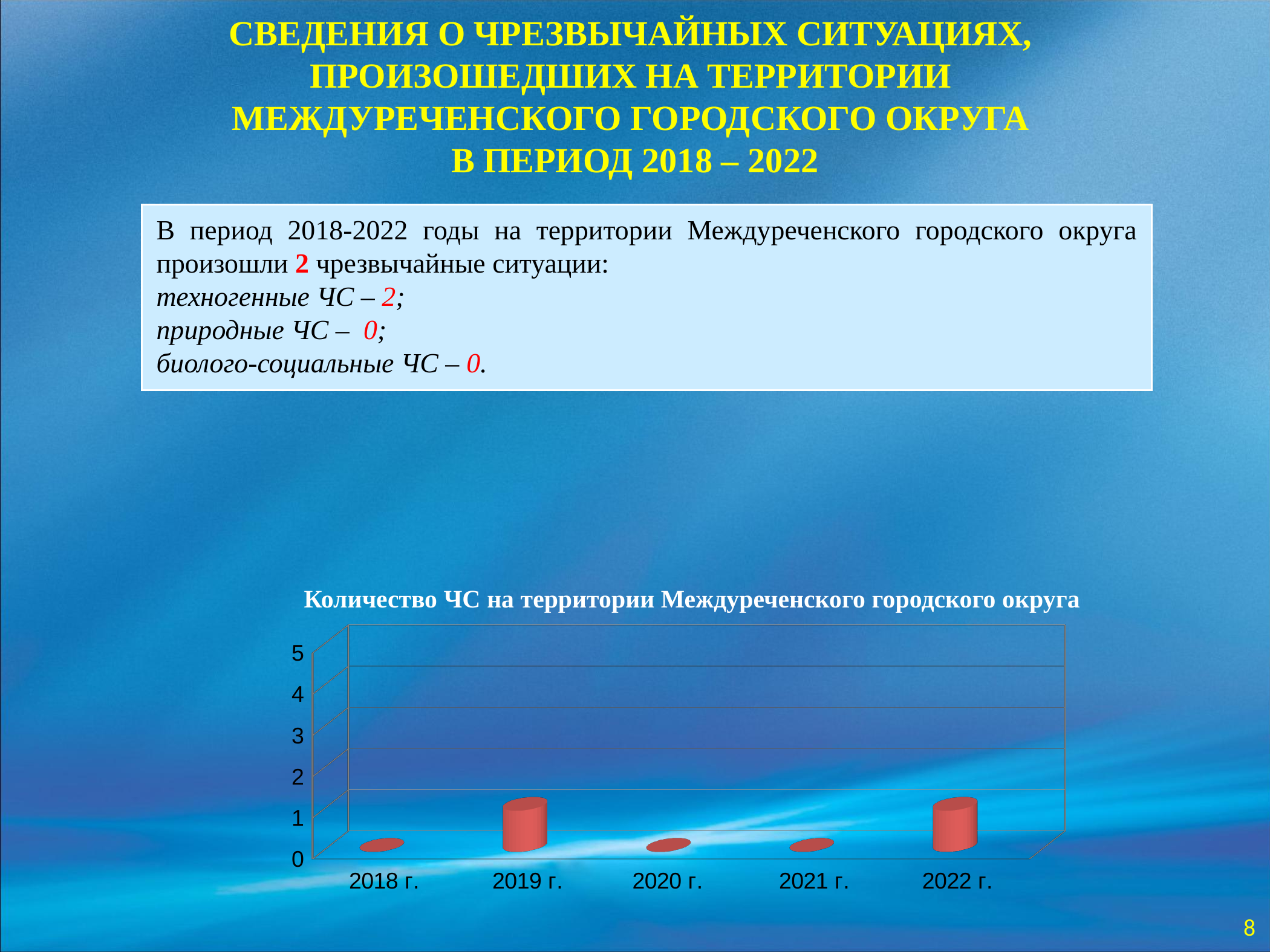
How many years (categories) are shown on the x axis of the chart? 5 What is the value for 2020 г. in the chart? 0 What is the value for 2022 г. in the chart? 1 What is the title of the chart? Количество ЧС на территории Междуреченского городского округа Which is larger, the value for 2019 г. or the value for 2020 г.? 2019 г. What is the value for 2019 г. in the chart? 1 What is the highest value shown on the vertical axis of the chart? 5 Which is larger, the value for 2021 г. or the value for 2022 г.? 2022 г. What is the difference between the values for 2019 г. and 2018 г.? 1 What is the value for 2018 г. in the chart? 0 Is the value for 2019 г. greater or less than 2? less What type of chart is shown on the slide? bar chart